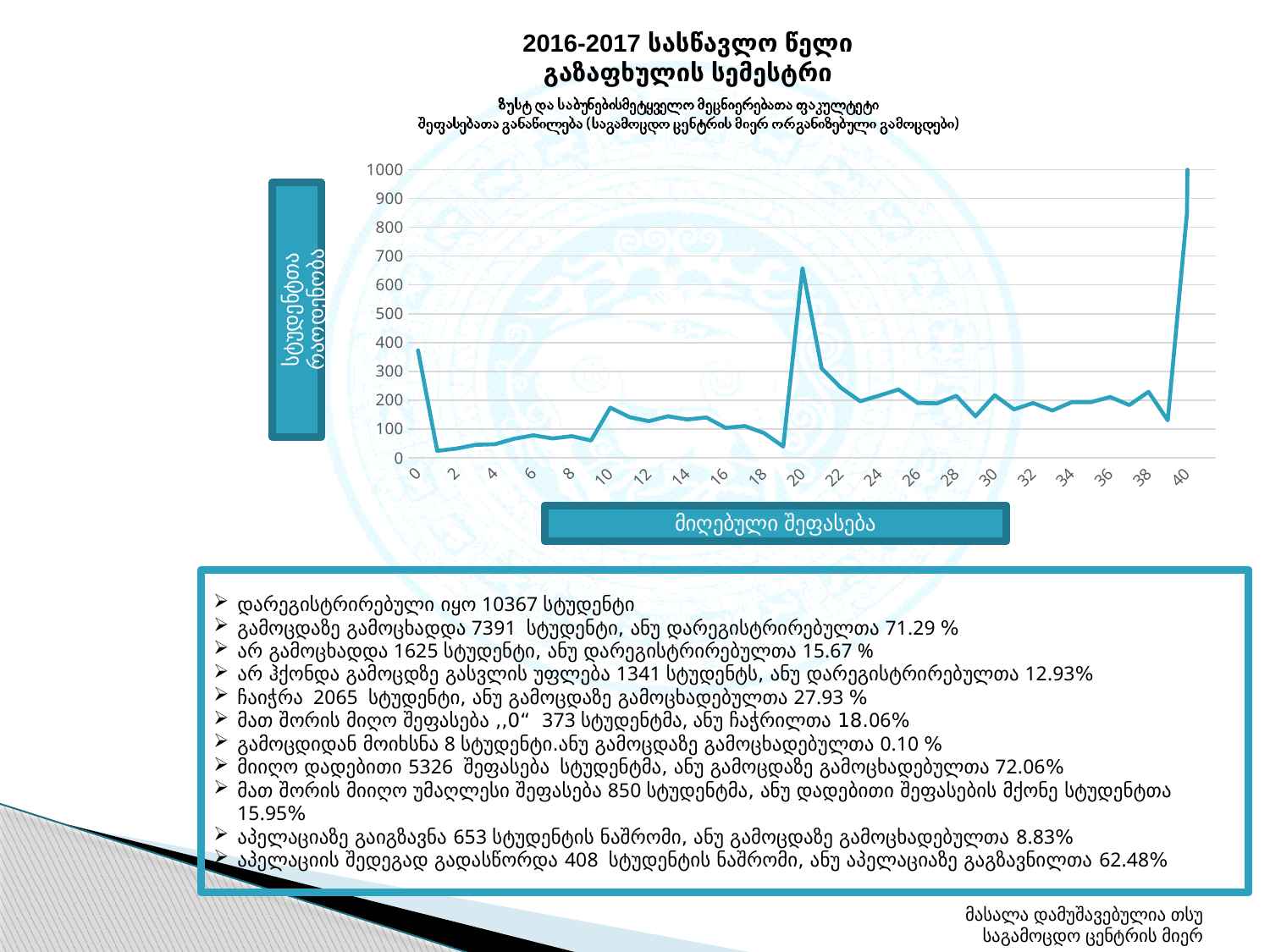
What is the label on the vertical axis of the chart? სტუდენტთა რაოდენობა Is the number of students for score 0 greater or less than 300? greater What kind of chart is shown on the slide? line chart Is the number of students for score 30 greater or less than 100? greater What is the label on the horizontal axis of the chart? მიღებული შეფასება Does the line rise or fall between score 20 and score 21? fall Which score has more students, 20 or 0? 20 At which score on the x axis does the line reach its highest value? 40 Is the number of students for score 1 greater or less than 100? less Which score has more students, 10 or 5? 10